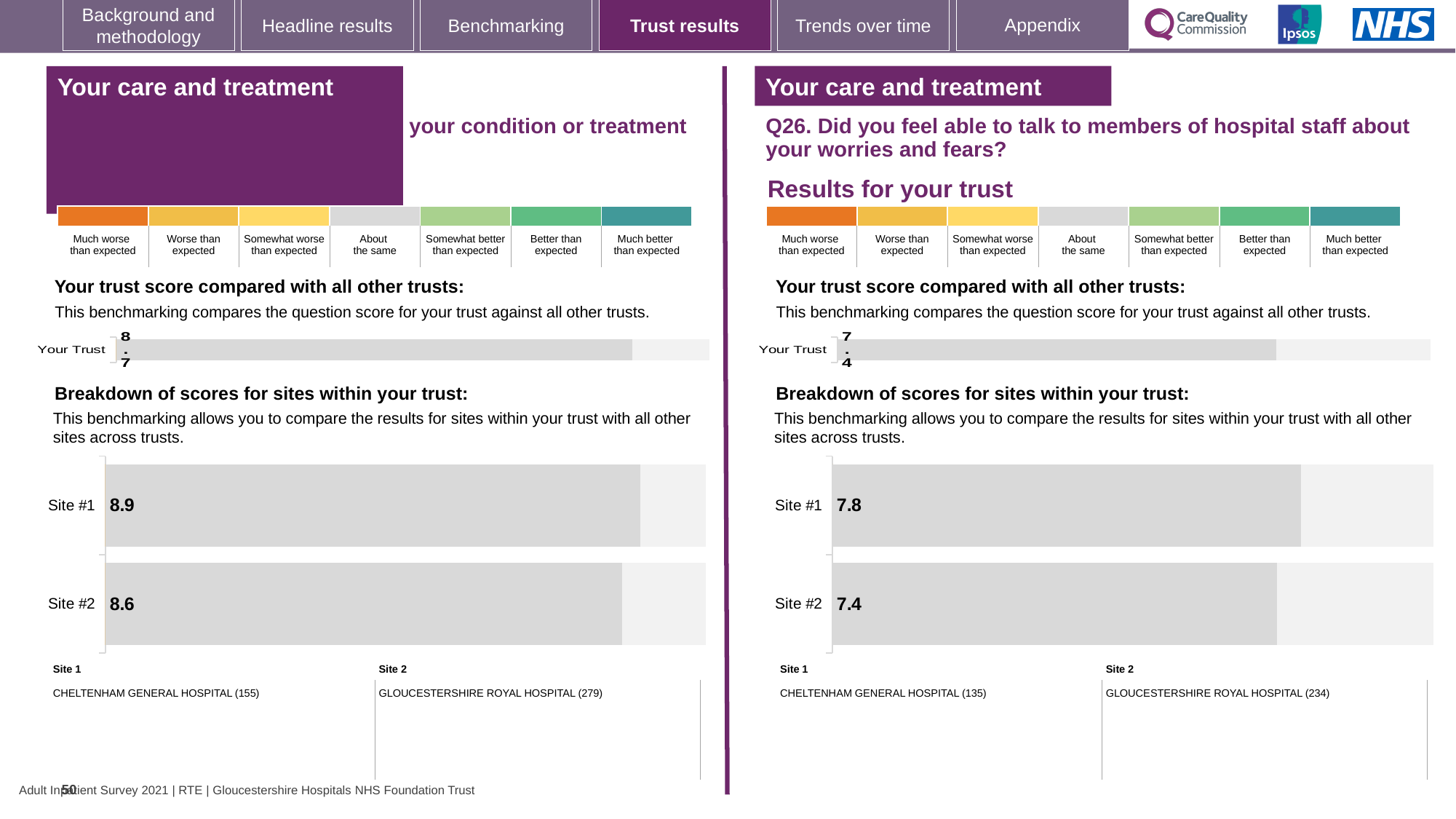
On the right-hand (Q26) sites breakdown chart, which site has the lower score? Site #2 On the left-hand sites breakdown chart, which site has the higher score? Site #1 On the left-hand 'Breakdown of scores for sites within your trust' chart, what is the score for Site #1? 8.9 On the left-hand 'Your trust score compared with all other trusts' chart, what is the score shown for Your Trust? 8.7 How many sites are shown on the right-hand (Q26) sites breakdown chart? 2 On the right-hand (Q26) sites breakdown chart, what is the difference between the Site #1 and Site #2 scores? 0.4 On the left-hand 'Breakdown of scores for sites within your trust' chart, what is the score for Site #2? 8.6 On the right-hand (Q26) 'Breakdown of scores for sites within your trust' chart, what is the score for Site #2? 7.4 On the right-hand (Q26) 'Your trust score compared with all other trusts' chart, what is the score shown for Your Trust? 7.4 On the right-hand (Q26) 'Breakdown of scores for sites within your trust' chart, what is the score for Site #1? 7.8 What type of chart is the left-hand 'Breakdown of scores for sites within your trust' chart? Bar chart On the left-hand sites breakdown chart, what is the difference between the Site #1 and Site #2 scores? 0.3